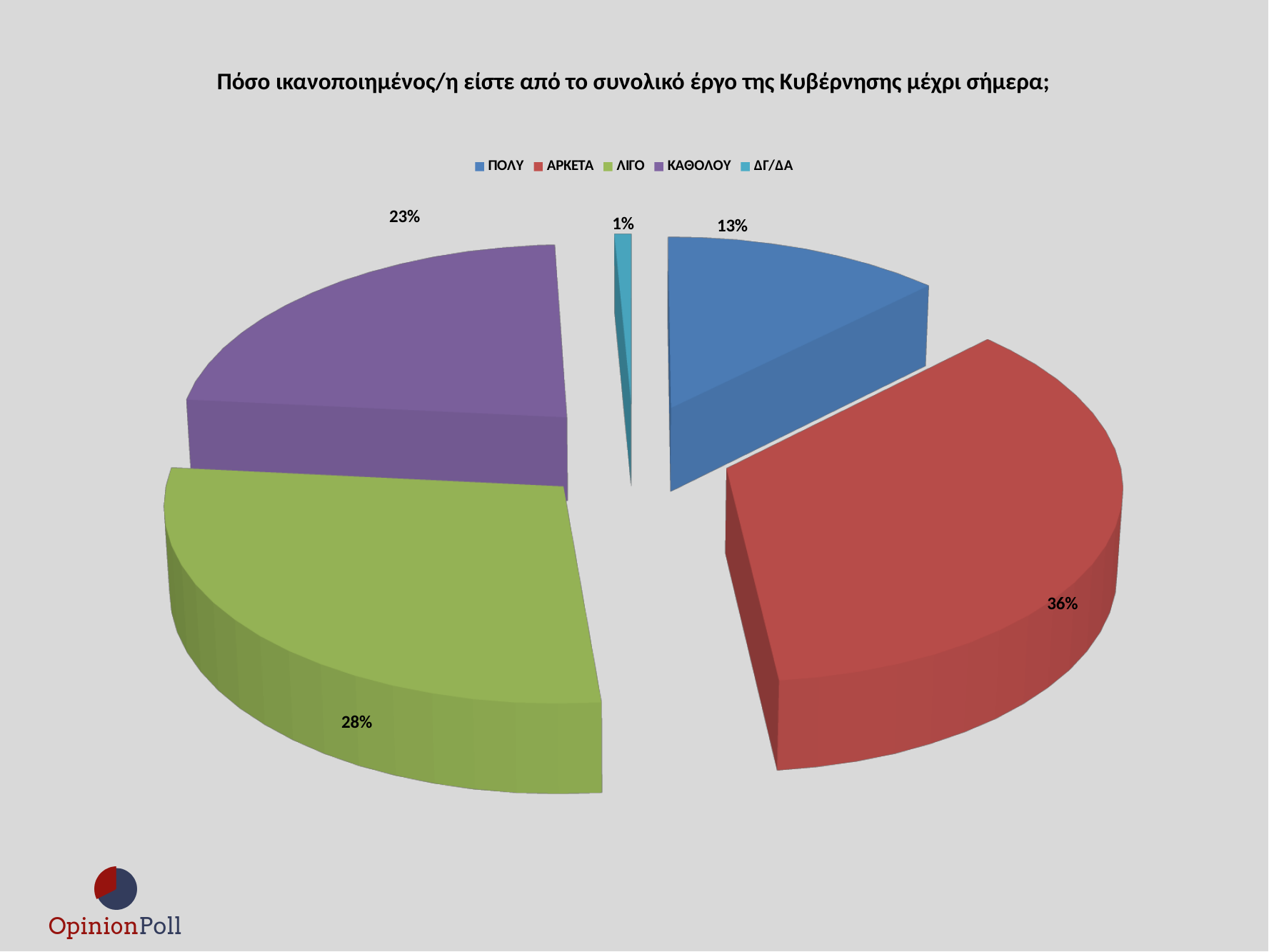
What percentage is shown for ΚΑΘΟΛΟΥ? 23% What percentage is shown for ΛΙΓΟ? 28% What colour is the slice for ΛΙΓΟ? green What percentage is shown for ΠΟΛΥ? 13% Which category has the largest share of the pie? ΑΡΚΕΤΑ Which category has the smallest share of the pie? ΔΓ/ΔΑ What percentage is shown for ΑΡΚΕΤΑ? 36% What percentage is shown for ΔΓ/ΔΑ? 1% Which is larger, the share for ΚΑΘΟΛΟΥ or the share for ΠΟΛΥ? ΚΑΘΟΛΟΥ How many categories does the legend list? 5 What type of chart is shown on the slide? pie chart What is the difference in percentage points between ΑΡΚΕΤΑ and ΛΙΓΟ? 8